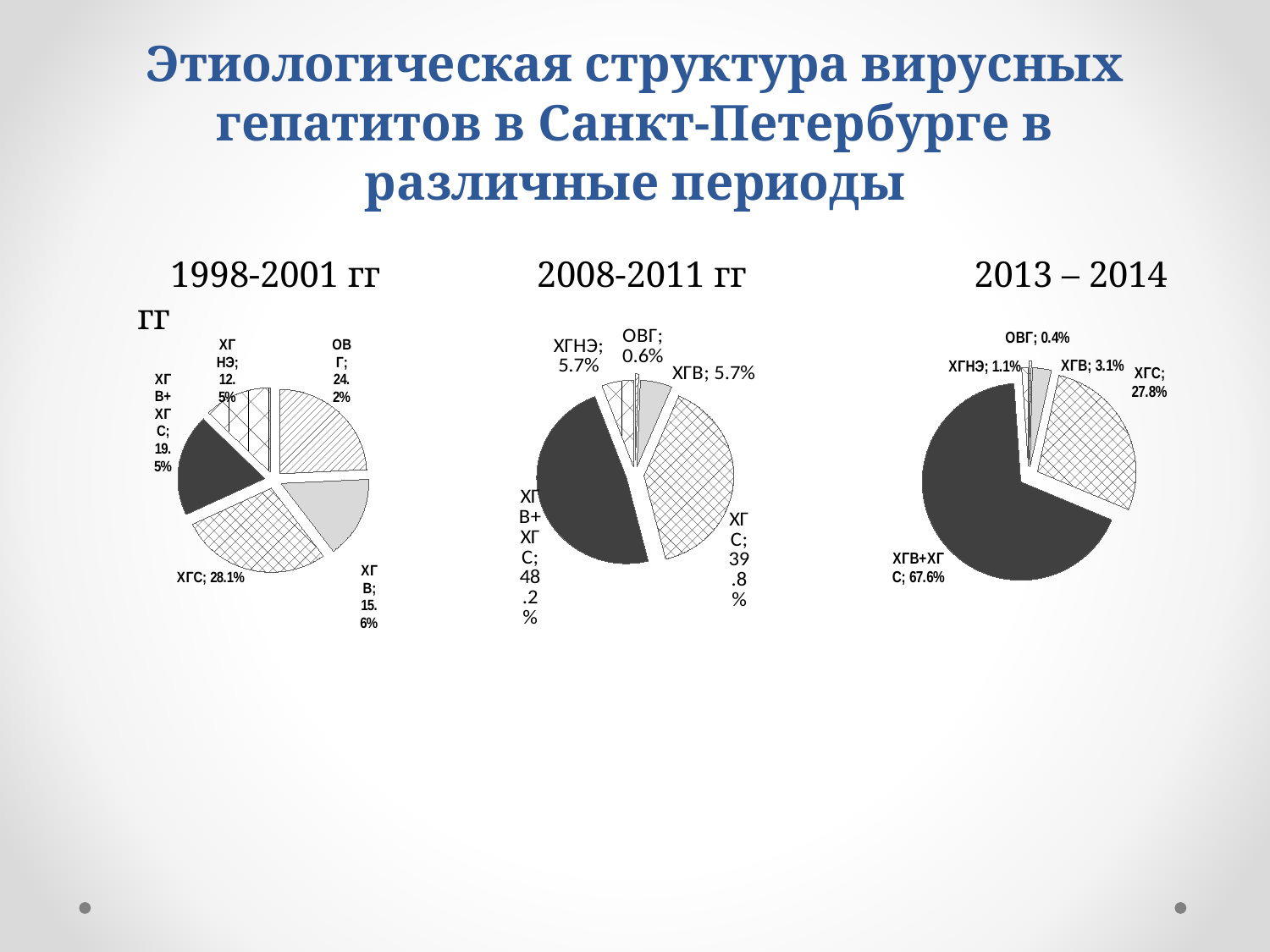
How many slices does the 2013 – 2014 pie chart have? 5 In the 2013 – 2014 pie chart, what share does ХГВ+ХГС have? 67.6% In the 2013 – 2014 pie chart, what share does ХГНЭ have? 1.1% In the 2008-2011 pie chart, what share does ХГВ+ХГС have? 48.2% What type of chart is used for the 2008-2011 period? Pie chart In the 1998-2001 pie chart, which category has the smallest share? ХГНЭ In the 1998-2001 pie chart, what share does ХГС have? 28.1% In the 2013 – 2014 pie chart, which is larger, the share of ХГС or the share of ХГВ? ХГС In the 1998-2001 pie chart, what share does ОВГ have? 24.2% In the 2008-2011 pie chart, what is the difference between the shares of ХГВ+ХГС and ХГС? 8.4% In the 2008-2011 pie chart, which category has the smallest share? ОВГ In the 1998-2001 pie chart, which category has the largest share? ХГС